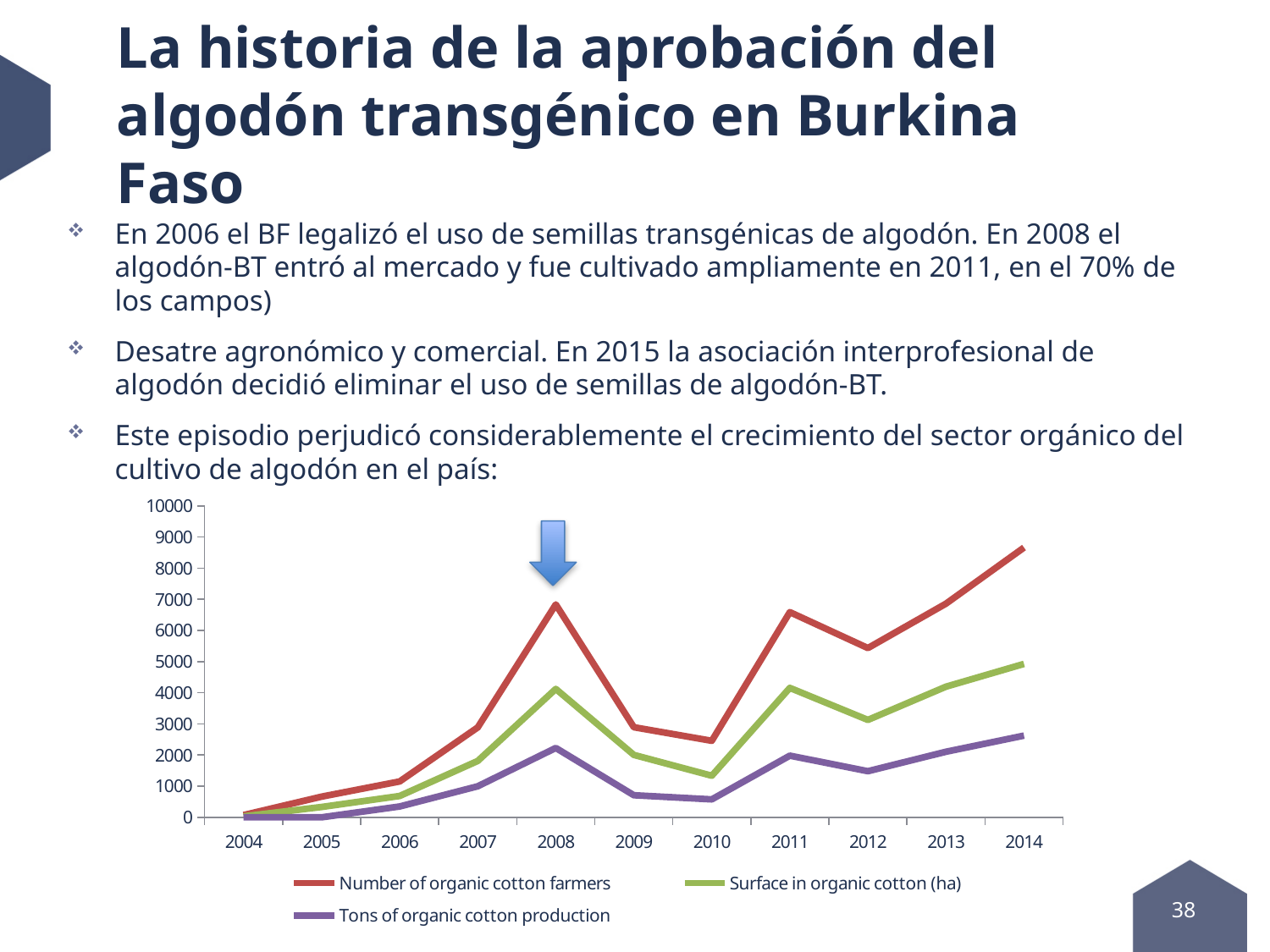
How many series does the chart legend list? 3 In 2011, which is larger: Number of organic cotton farmers or Surface in organic cotton (ha)? Number of organic cotton farmers How many years are shown on the x axis of the chart? 11 What colour is the line for Tons of organic cotton production? purple What kind of chart is shown on the slide? line chart In which year is the Number of organic cotton farmers highest? 2014 Is the Surface in organic cotton (ha) in 2014 greater or less than 4000? greater Is the value for Tons of organic cotton production in 2008 greater or less than 3000? less Is the Number of organic cotton farmers in 2010 greater or less than 3000? less Does the Number of organic cotton farmers rise or fall from 2008 to 2010? fall Does Tons of organic cotton production rise or fall from 2012 to 2014? rise